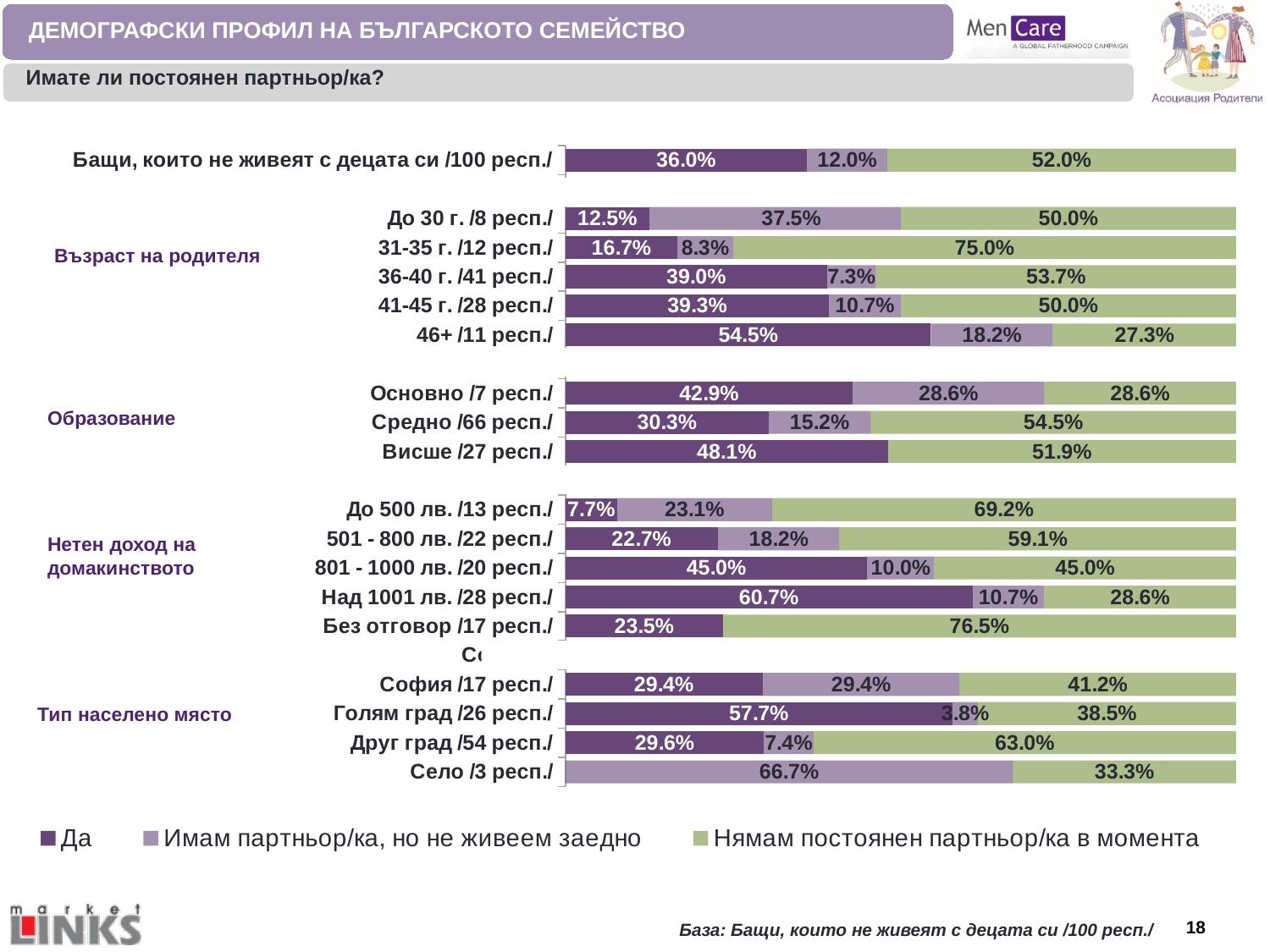
What is the value of "Да" for "Бащи, които не живеят с децата си /100 респ./"? 36.0% What is the value of "Нямам постоянен партньор/ка в момента" for "31-35 г. /12 респ./"? 75.0% What kind of chart is shown on the slide? Stacked bar chart Which legend entry is shown in the dark purple colour? Да How many series does the legend list? 3 Among the household income groups (Нетен доход на домакинството), which category has the lowest value for "Да"? До 500 лв. /13 респ./ What is the total of the stacked bar for "Друг град /54 респ./"? 100.0% Among the age groups (Възраст на родителя), which category has the highest value for "Да"? 46+ /11 респ./ What is the value of "Имам партньор/ка, но не живеем заедно" for "Село /3 респ./"? 66.7% Which has a larger "Да" value: "София /17 респ./" or "Голям град /26 респ./"? Голям град /26 респ./ What is the difference between the "Да" values for "Над 1001 лв. /28 респ./" and "До 500 лв. /13 респ./"? 53.0 percentage points What is the value of "Имам партньор/ка, но не живеем заедно" for "Основно /7 респ./"? 28.6%